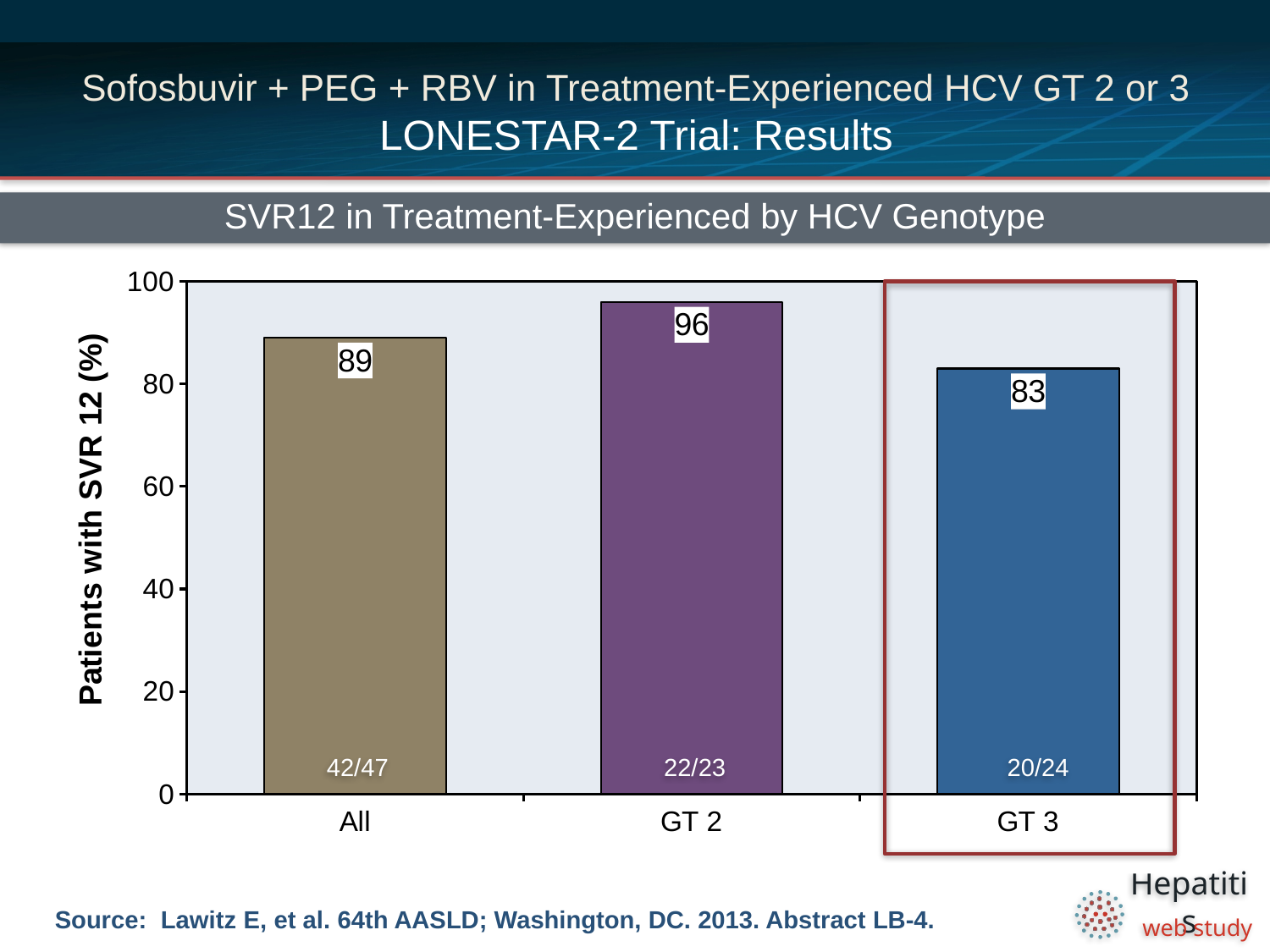
How many categories are shown on the x axis? 3 What is the SVR12 value for the All group? 89 Which is larger, the SVR12 value for All or for GT 3? All What kind of chart is shown on the slide? bar chart What fraction of patients is printed on the GT 2 bar? 22/23 What is the title of the chart? SVR12 in Treatment-Experienced by HCV Genotype What is the SVR12 value for GT 2? 96 Which category has the highest SVR12 rate? GT 2 Is the value for GT 3 greater or less than 80? greater What is the difference between the SVR12 values for GT 2 and GT 3? 13 What is the SVR12 value for GT 3? 83 Which category has the lowest SVR12 rate? GT 3